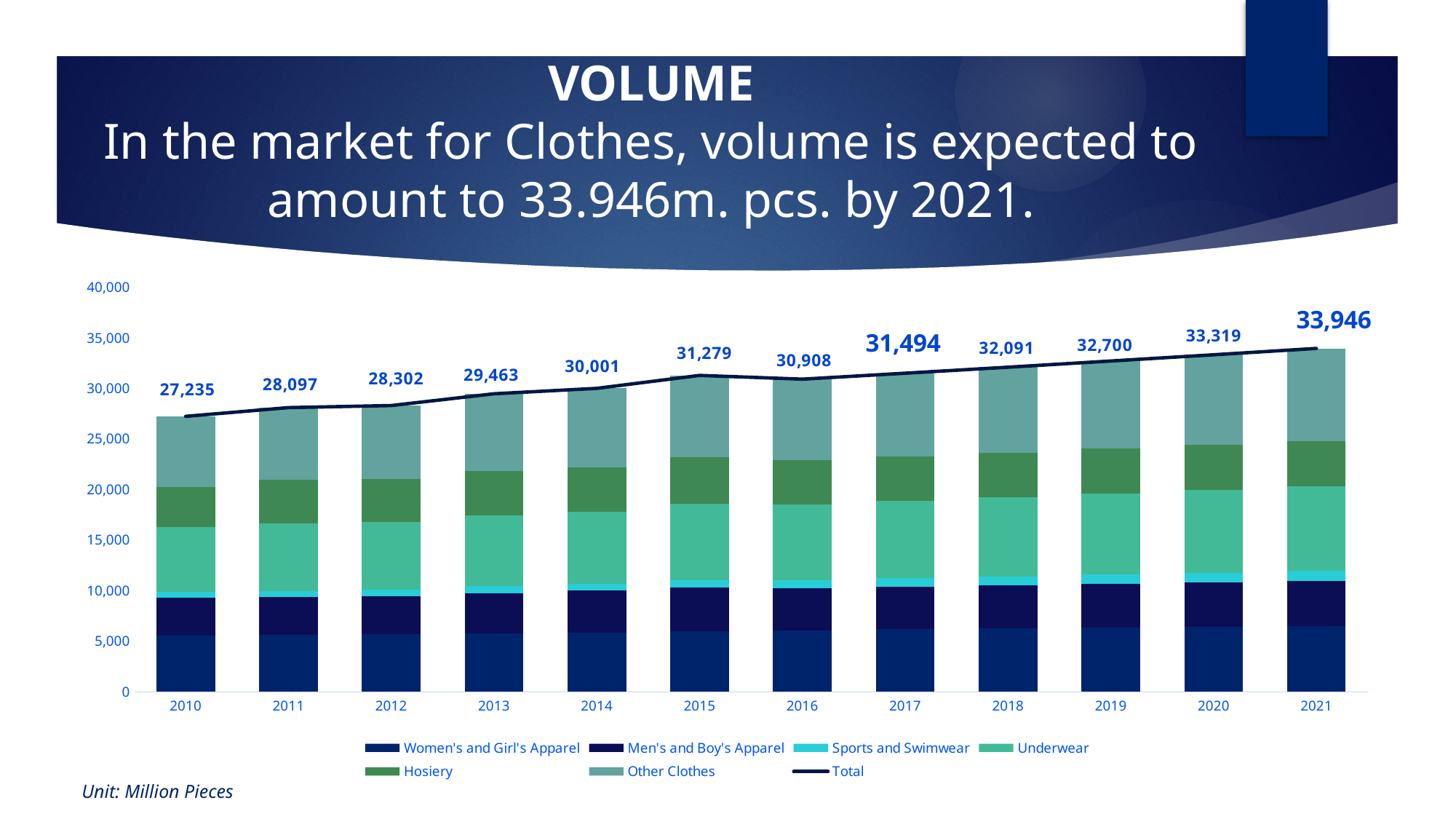
What is the difference between the total volume in 2021 and in 2010? 6,711 What unit is stated for the values in the chart? Million Pieces What is the total volume shown for 2010? 27,235 What kind of chart is shown on the slide? Stacked bar chart with a line Which year has the larger total volume, 2015 or 2016? 2015 Which year has the lowest total volume? 2010 How many years are shown on the x axis? 12 How many entries does the legend list? 7 What is the total volume shown for 2016? 30,908 Is the value for Women's and Girl's Apparel in 2010 greater or less than 10,000? less Which year has the highest total volume? 2021 What is the total volume shown for 2021? 33,946